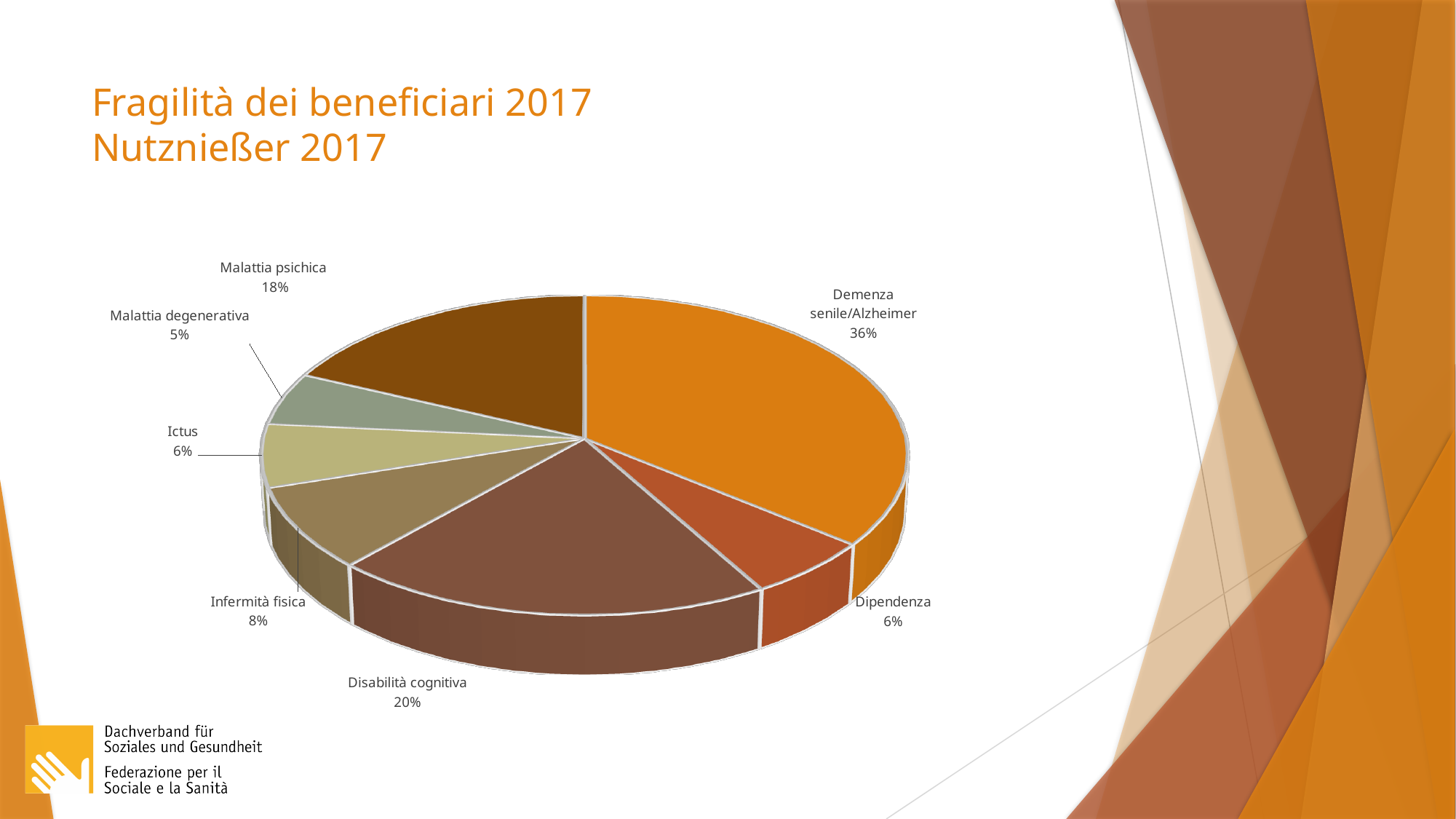
What is the difference between the shares of Disabilità cognitiva and Malattia psichica? 2% Which category has the largest slice of the pie? Demenza senile/Alzheimer What is the difference between the shares of Demenza senile/Alzheimer and Dipendenza? 30% Which is larger, the share for Infermità fisica or the share for Ictus? Infermità fisica What kind of chart is shown on the slide? pie chart What is the value shown for Disabilità cognitiva? 20% What is the value shown for Malattia psichica? 18% What is the value shown for Infermità fisica? 8% What is the title of the slide containing the chart? Fragilità dei beneficiari 2017 Nutznießer 2017 How many slices does the pie chart have? 7 Which category has the smallest slice of the pie? Malattia degenerativa What share of the pie does Demenza senile/Alzheimer represent? 36%